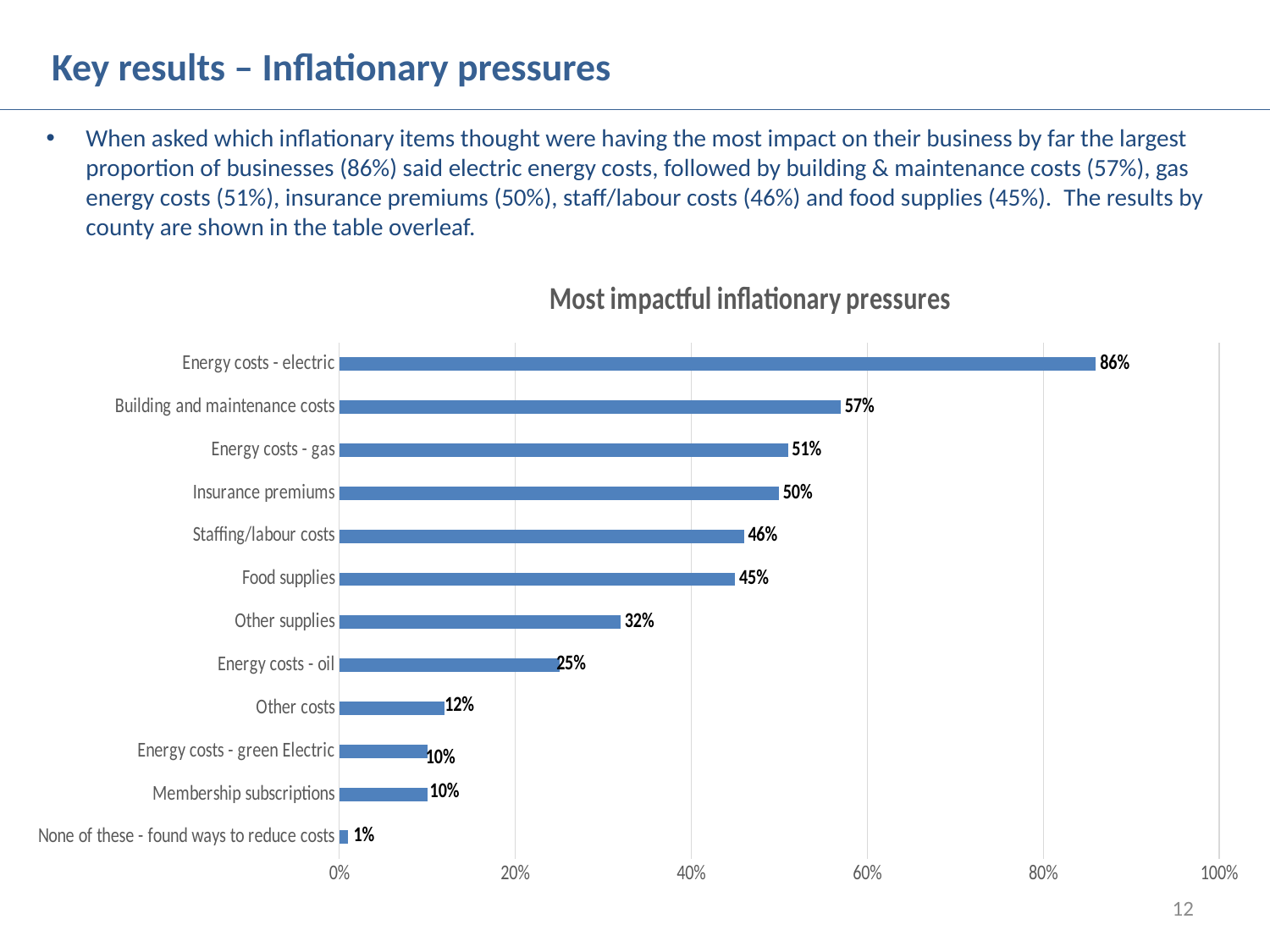
Is the value for Building and maintenance costs greater or less than 60%? less What is the value for Insurance premiums? 50% How many categories are shown in the chart? 12 What is the difference between Energy costs - electric and Building and maintenance costs? 29% What is the value for Other supplies? 32% What kind of chart is shown on the slide? bar chart Which category has the lowest value? None of these - found ways to reduce costs What is the difference between Energy costs - gas and Energy costs - oil? 26% What is the value for Energy costs - electric? 86% What is the title of the chart? Most impactful inflationary pressures Which is larger, Food supplies or Other supplies? Food supplies Which category has the highest value? Energy costs - electric